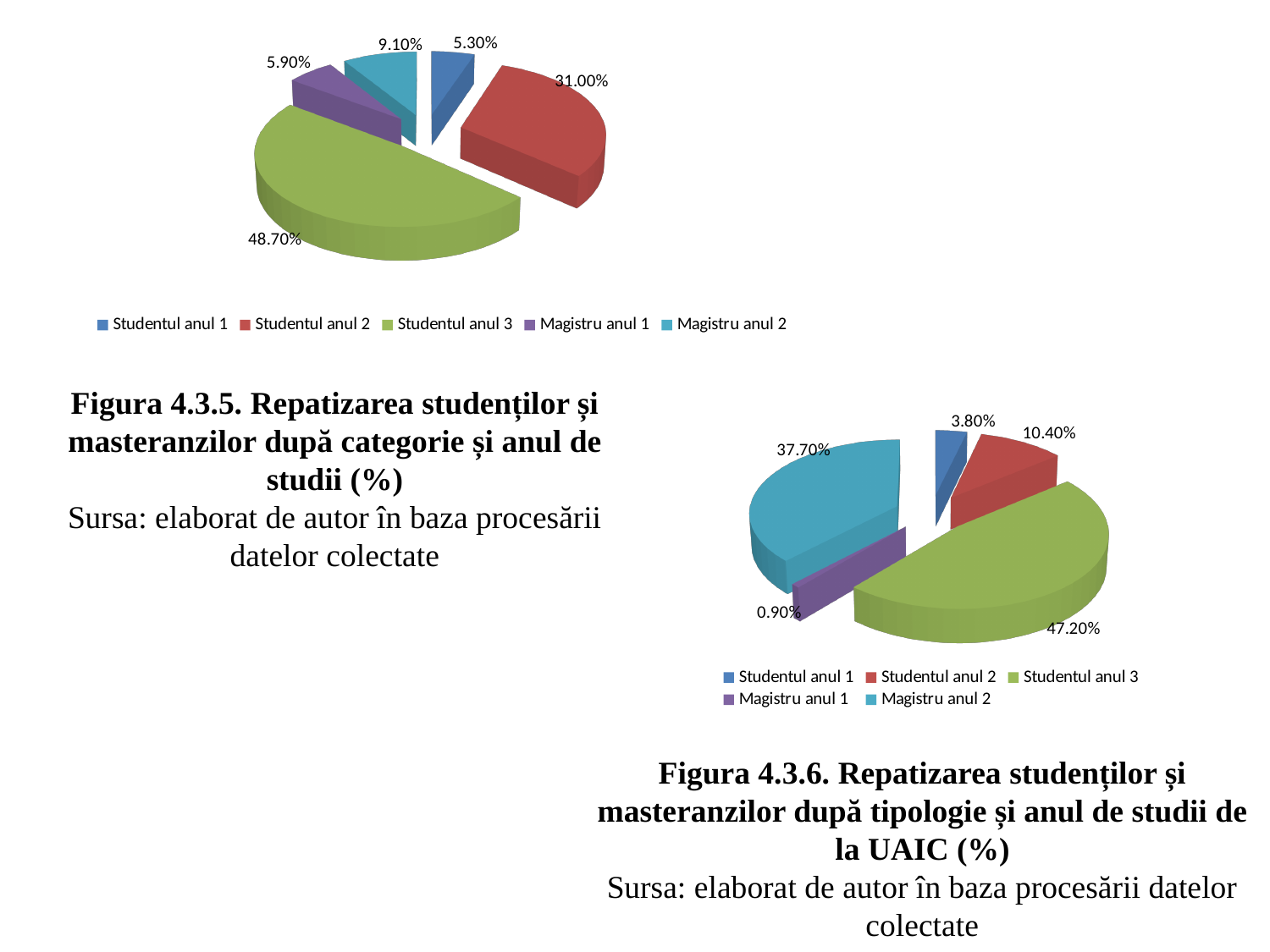
What type of chart is the bottom-right chart (Figura 4.3.6)? Pie chart In the top-left pie chart (Figura 4.3.5), what is the value for Studentul anul 3? 48.70% In the top-left pie chart (Figura 4.3.5), which is larger: Magistru anul 1 or Magistru anul 2? Magistru anul 2 In the bottom-right pie chart (Figura 4.3.6), what is the value for Magistru anul 2? 37.70% In the top-left pie chart (Figura 4.3.5), what is the difference between Studentul anul 3 and Studentul anul 2? 17.70% In the bottom-right pie chart (Figura 4.3.6), what is the value for Magistru anul 1? 0.90% In the bottom-right pie chart (Figura 4.3.6), which category has the largest share? Studentul anul 3 In the bottom-right pie chart (Figura 4.3.6), what is the difference between Studentul anul 2 and Studentul anul 1? 6.60% How many entries does the legend of the bottom-right pie chart (Figura 4.3.6) list? 5 How many slices does the top-left pie chart (Figura 4.3.5) have? 5 In the top-left pie chart (Figura 4.3.5), which category has the smallest share? Studentul anul 1 In the top-left pie chart (Figura 4.3.5), what is the value for Magistru anul 2? 9.10%